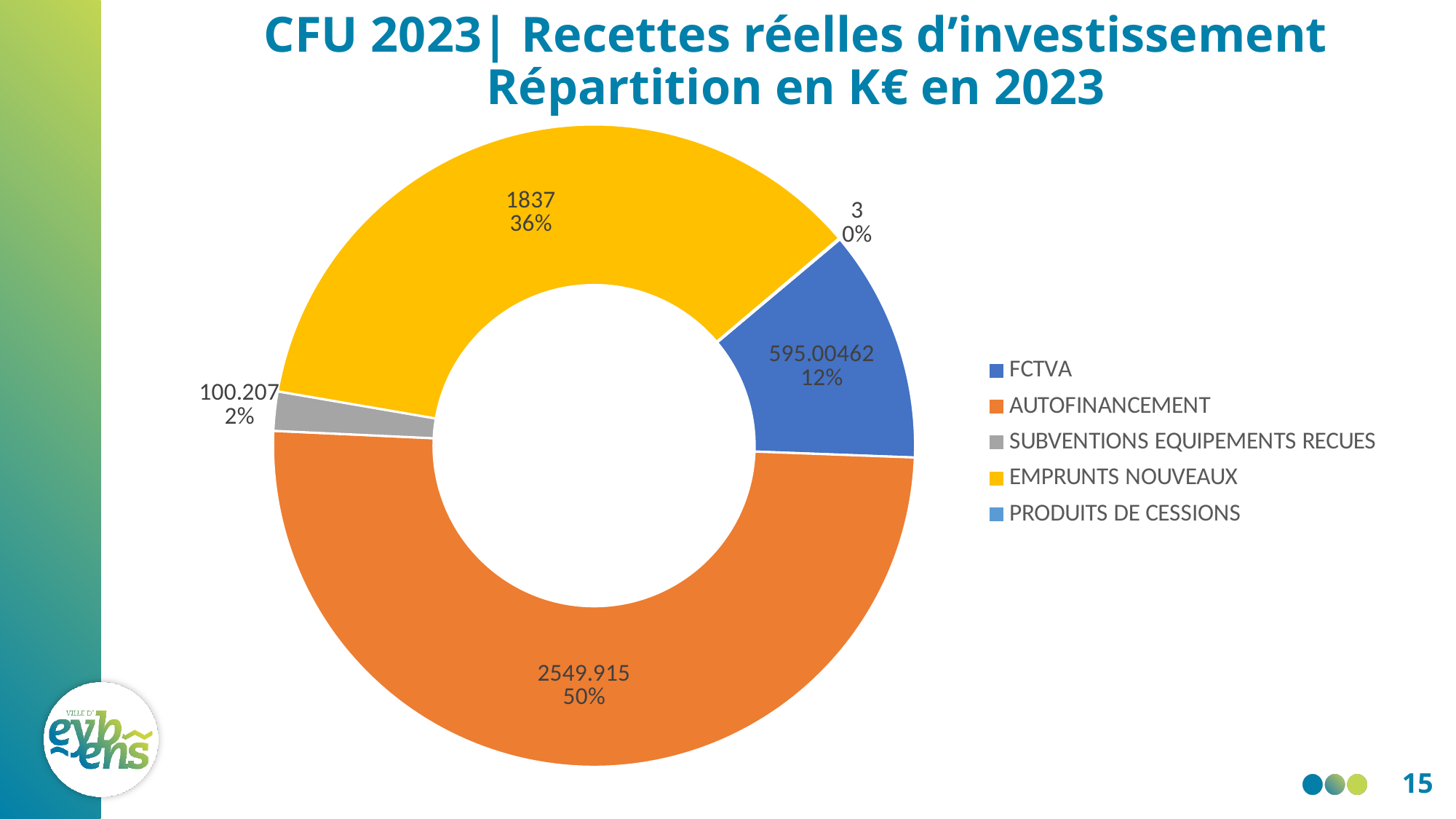
How many categories does the legend list? 5 What value is shown for FCTVA? 595.00462 What kind of chart is shown on the slide? doughnut chart Which category has the largest value? AUTOFINANCEMENT What percentage share does FCTVA represent? 12% What value is shown for SUBVENTIONS EQUIPEMENTS RECUES? 100.207 What value is shown for AUTOFINANCEMENT? 2549.915 What is the difference between the values for AUTOFINANCEMENT and EMPRUNTS NOUVEAUX? 712.915 What value is shown for EMPRUNTS NOUVEAUX? 1837 Which category has the smallest value? PRODUITS DE CESSIONS What percentage share does EMPRUNTS NOUVEAUX represent? 36% Which is larger, the value for FCTVA or the value for SUBVENTIONS EQUIPEMENTS RECUES? FCTVA